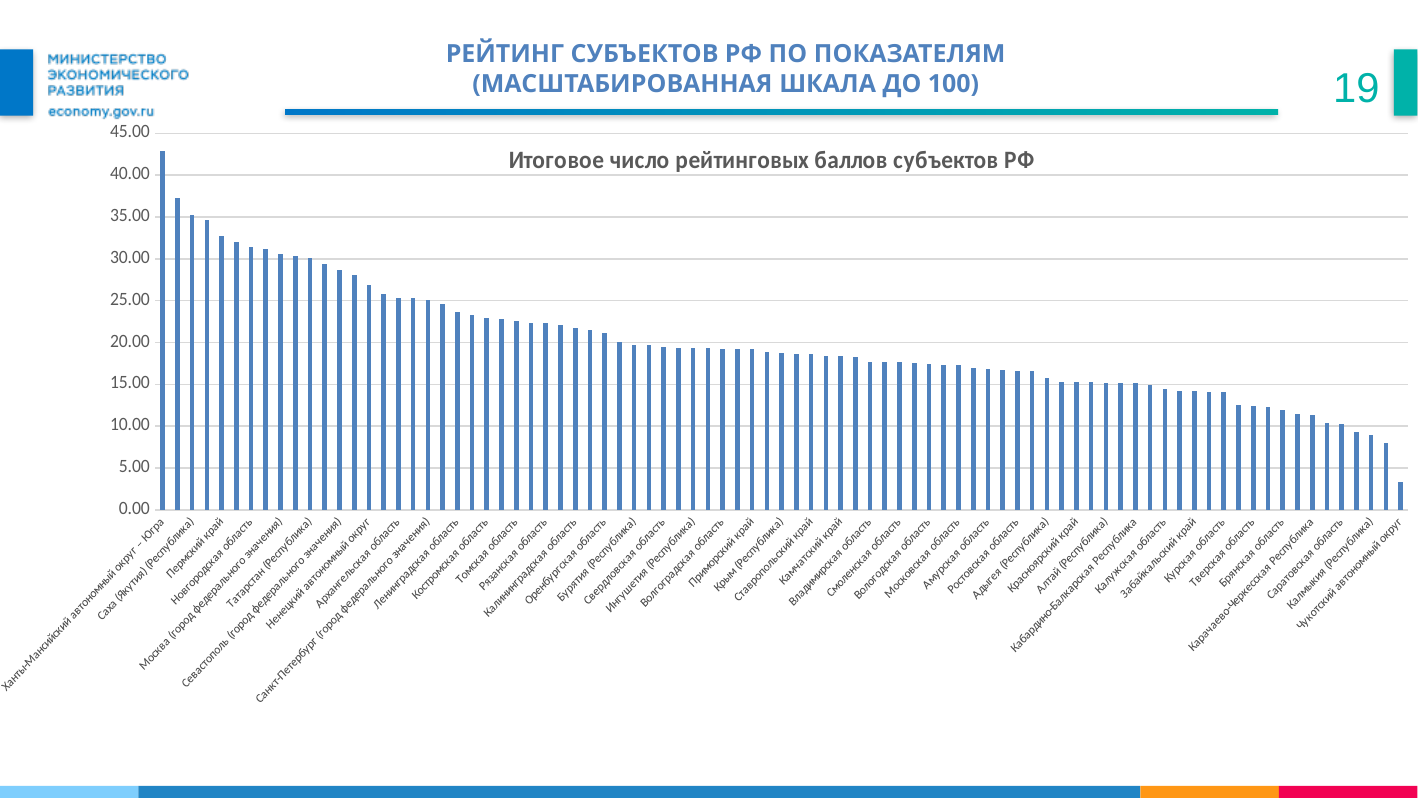
Which region has the lowest value in the chart? Чукотский автономный округ Which region has the highest value in the chart? Ханты-Мансийский автономный округ – Югра Is the value for Курская область greater or less than 15.00? less Which has the larger value, Пермский край or Томская область? Пермский край Is the value for Пермский край greater or less than 30.00? greater Is the value for Чукотский автономный округ greater or less than 5.00? less What kind of chart is shown on the slide? bar chart What is the title of the chart? Итоговое число рейтинговых баллов субъектов РФ Which has the larger value, Ханты-Мансийский автономный округ – Югра or Саха (Якутия) (Республика)? Ханты-Мансийский автономный округ – Югра Do the values rise or fall from left to right along the x axis? fall